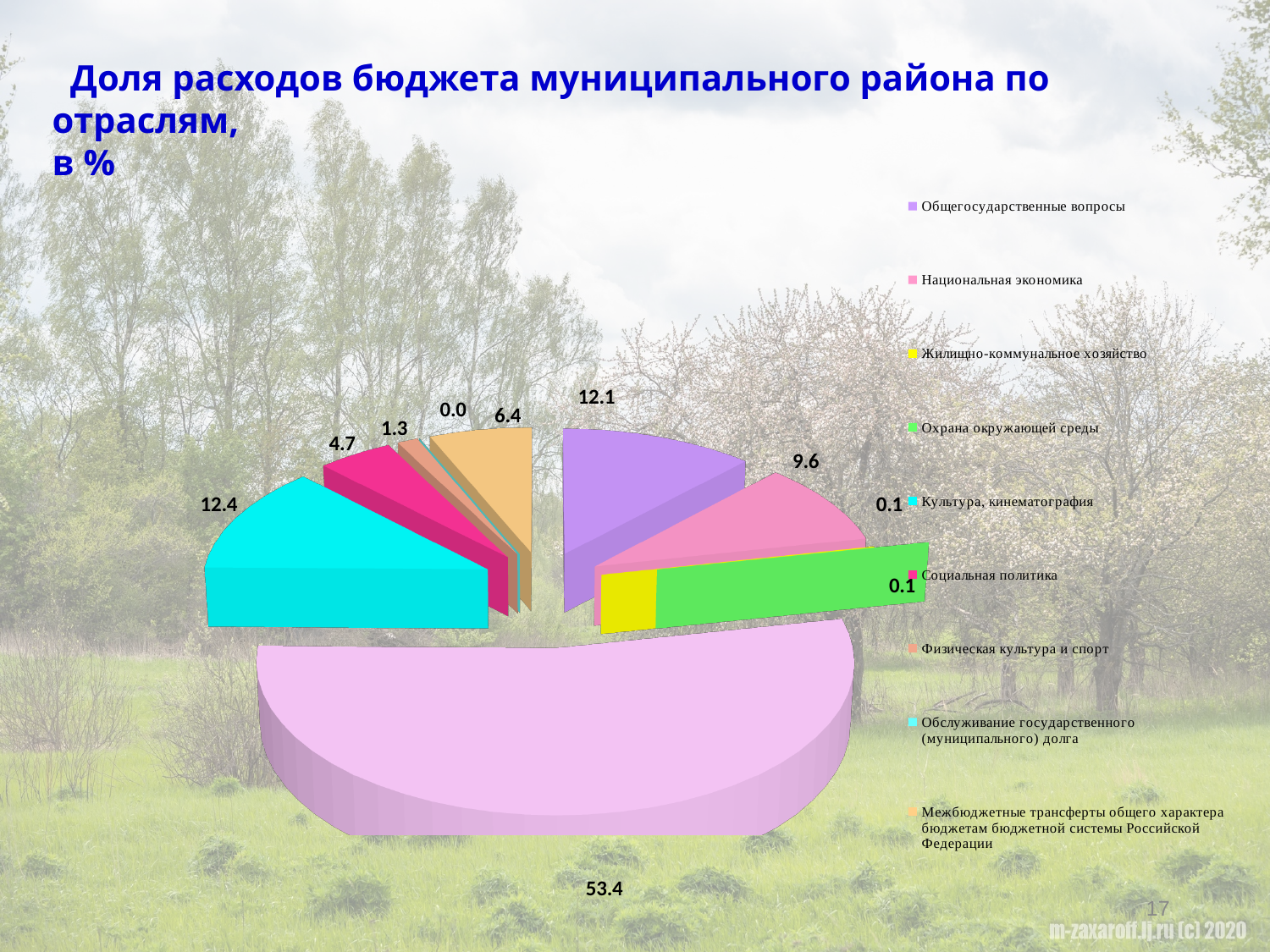
What is the value shown for Национальная экономика? 9.6 Which legend category has the smallest value, 0.0? Обслуживание государственного (муниципального) долга What is the value shown for Социальная политика? 4.7 How many entries does the legend list? 9 What is the value shown for Межбюджетные трансферты общего характера бюджетам бюджетной системы Российской Федерации? 6.4 What is the value shown for Общегосударственные вопросы? 12.1 What is the value of the largest slice of the pie? 53.4 What is the difference between the value for Культура, кинематография and the value for Общегосударственные вопросы? 0.3 What kind of chart is shown on the slide? pie chart Which is larger, the value for Общегосударственные вопросы or the value for Национальная экономика? Общегосударственные вопросы What is the value shown for Физическая культура и спорт? 1.3 What is the value shown for Культура, кинематография? 12.4